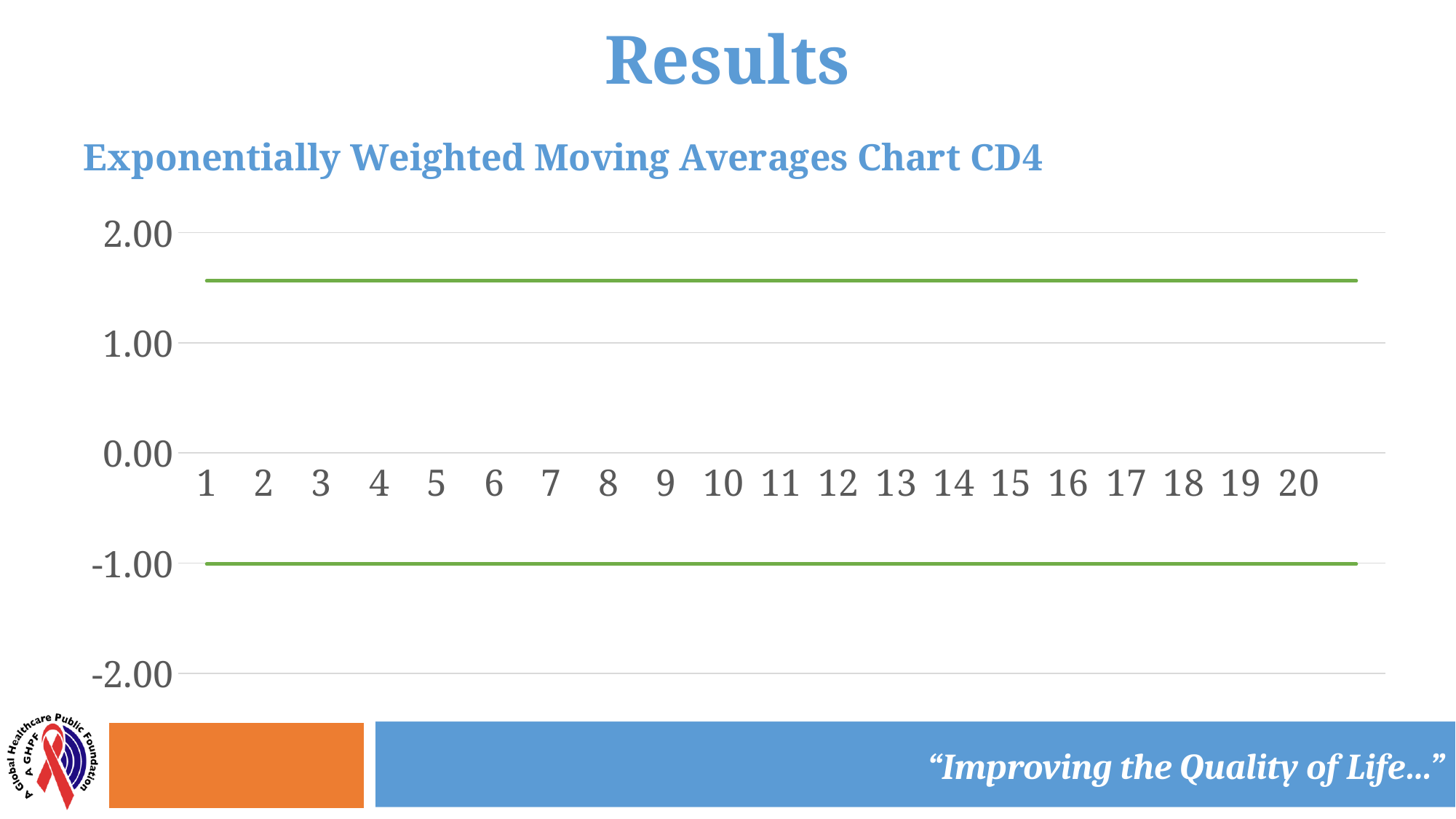
Is the value of the upper green line greater or less than 2.00? less What is the title of the chart? Exponentially Weighted Moving Averages Chart CD4 Is the value of the upper green line greater or less than 1.00? greater How many lines are plotted on the chart? 2 Do the plotted lines rise, fall, or stay flat from x = 1 to x = 20? stay flat Which of the two lines is higher, the upper line or the lower line at -1.00? the upper line How many points are labelled along the x axis of the chart? 20 What kind of chart is shown on the slide? line chart What is the lowest value shown on the y axis? -2.00 Is the value of the lower green line greater or less than 0.00? less What value does the lower green line sit at on the y axis? -1.00